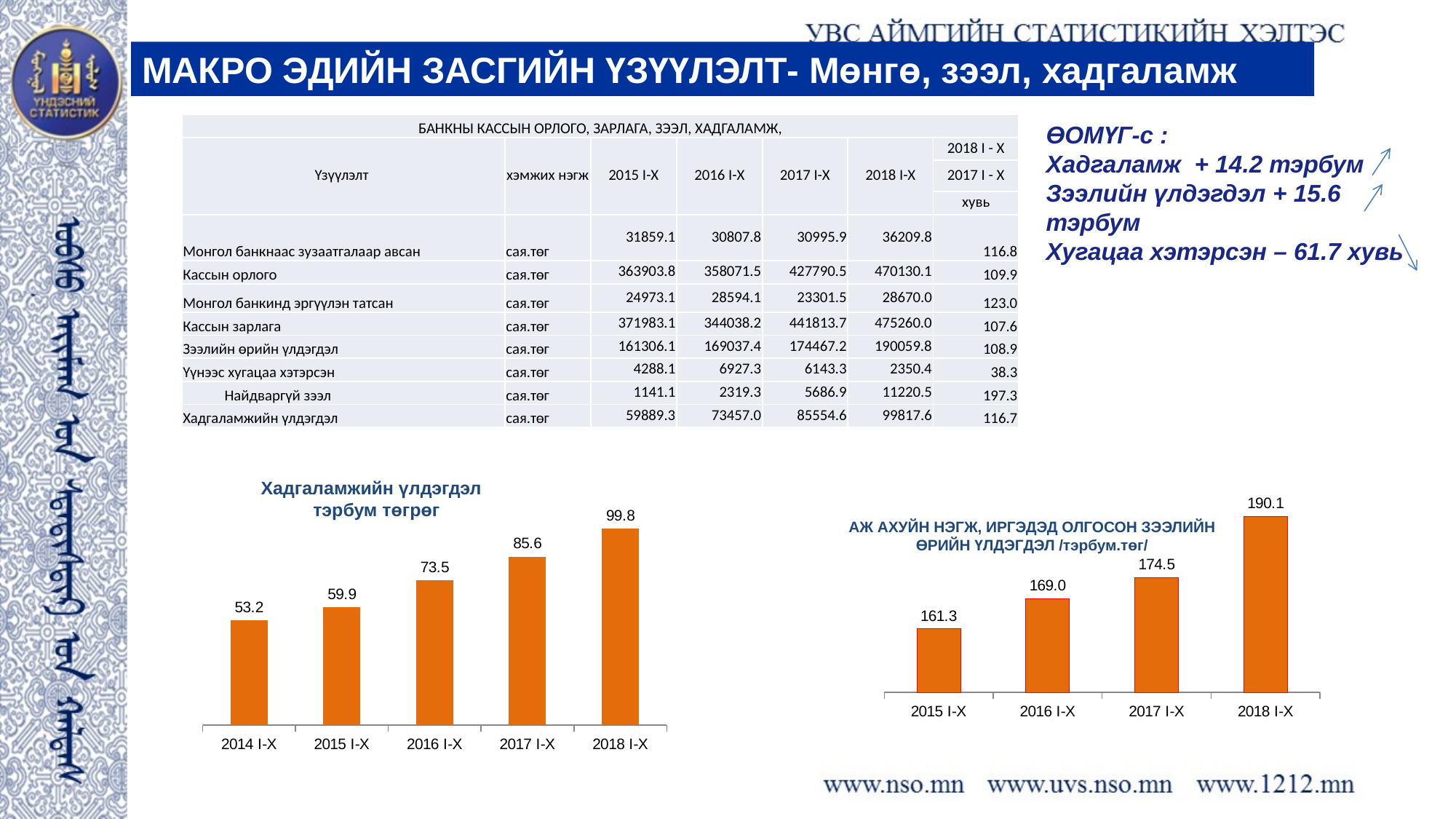
What type of chart is the right chart (Зээлийн өрийн үлдэгдэл)? bar chart In the right chart (Зээлийн өрийн үлдэгдэл), what is the value for 2015 I-X? 161.3 In the left chart (Хадгаламжийн үлдэгдэл), what is the difference between the 2018 I-X and 2017 I-X values? 14.2 In the right chart (Зээлийн өрийн үлдэгдэл), what is the difference between the 2018 I-X and 2017 I-X values? 15.6 In the left chart (Хадгаламжийн үлдэгдэл), which year has the lowest value? 2014 I-X In the left chart (Хадгаламжийн үлдэгдэл), do the values rise or fall from 2014 I-X to 2018 I-X? rise In the left chart (Хадгаламжийн үлдэгдэл), what is the value for 2016 I-X? 73.5 In the right chart (Зээлийн өрийн үлдэгдэл), which is larger, the value for 2016 I-X or 2015 I-X? 2016 I-X In the left chart (Хадгаламжийн үлдэгдэл), which year has the highest value? 2018 I-X In the right chart (Зээлийн өрийн үлдэгдэл), what is the value for 2017 I-X? 174.5 In the left chart (Хадгаламжийн үлдэгдэл), how many bars are plotted? 5 In the left chart (Хадгаламжийн үлдэгдэл), what is the value for 2014 I-X? 53.2